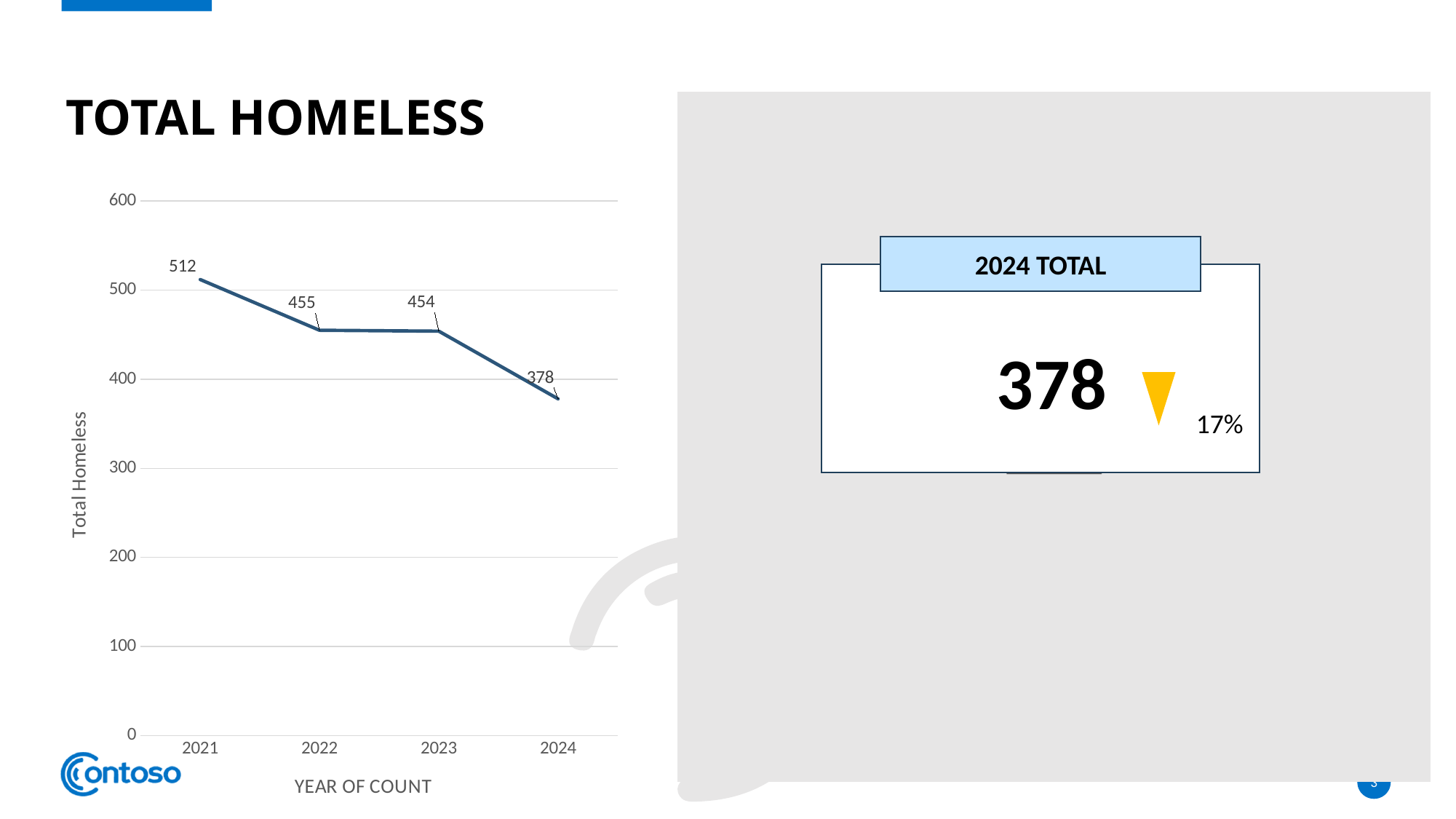
Do the values rise or fall from 2021 to 2024? fall Is the value for 2024 greater or less than 400? less What is the difference between the 2023 and 2024 values? 76 How many years are plotted on the chart? 4 Which year has the highest total homeless value? 2021 What is the difference between the 2021 and 2024 values? 134 What kind of chart is shown on the slide? line chart Which is larger, the value for 2021 or the value for 2023? 2021 What is the total homeless value for 2021? 512 What is the total homeless value for 2024? 378 What is the total homeless value for 2022? 455 Which year has the lowest total homeless value? 2024